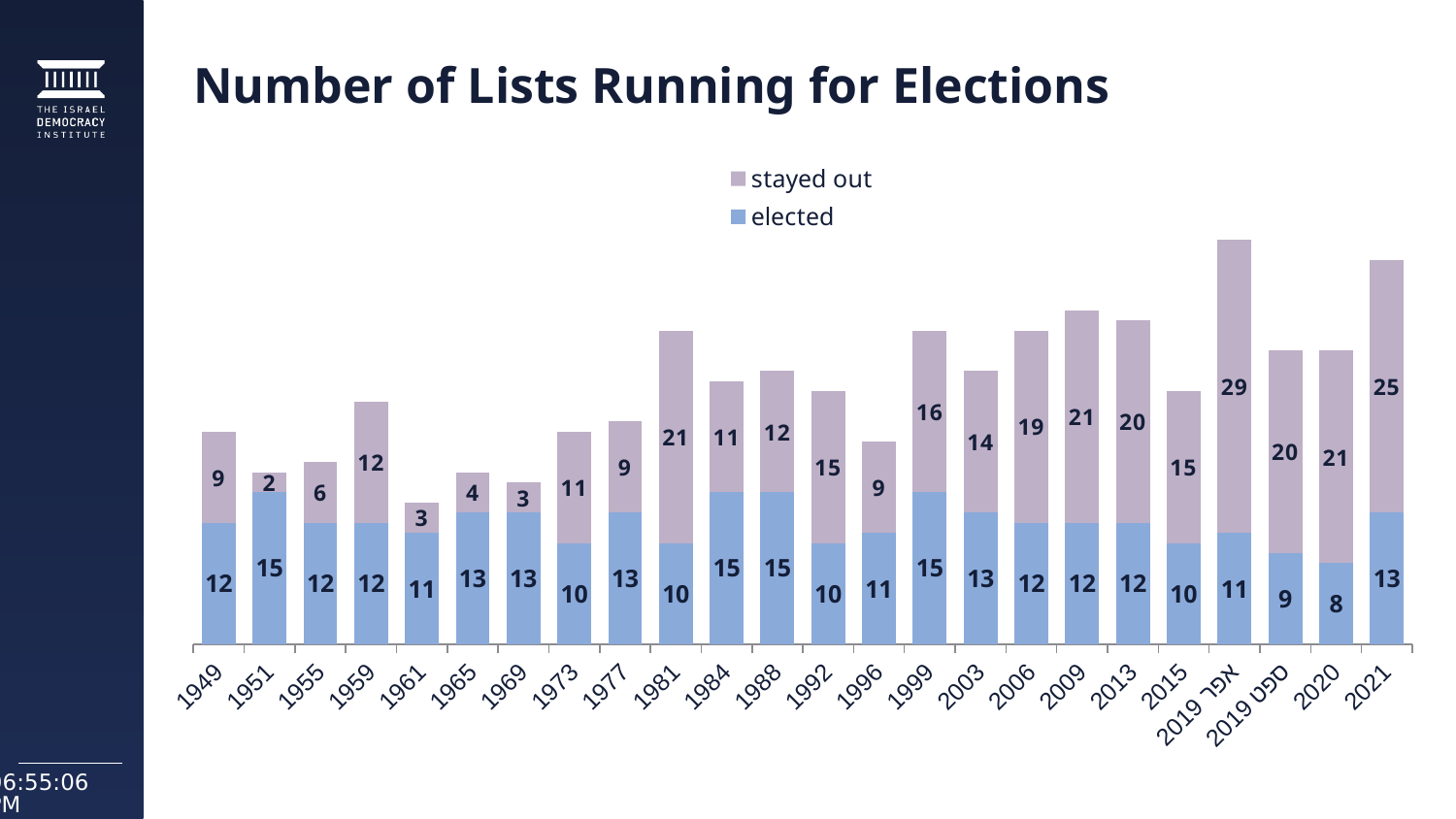
What is the total number of lists running in the 2009 election (elected plus stayed out)? 33 How many lists were elected in 1951? 15 Which election year has the lowest number of lists that stayed out? 1951 How many lists were elected in 2020? 8 What are the two series named in the legend? stayed out, elected What is the difference between the number of lists that stayed out in 1981 and in 1977? 12 How many election years (categories) are shown on the x axis? 24 Which election year has the highest number of lists that stayed out? 2019 אפר What type of chart is shown on the slide? stacked bar chart Which is larger: the number of lists that stayed out in 1999 or in 2003? 1999 How many series does the legend list? 2 How many lists stayed out in 2021? 25